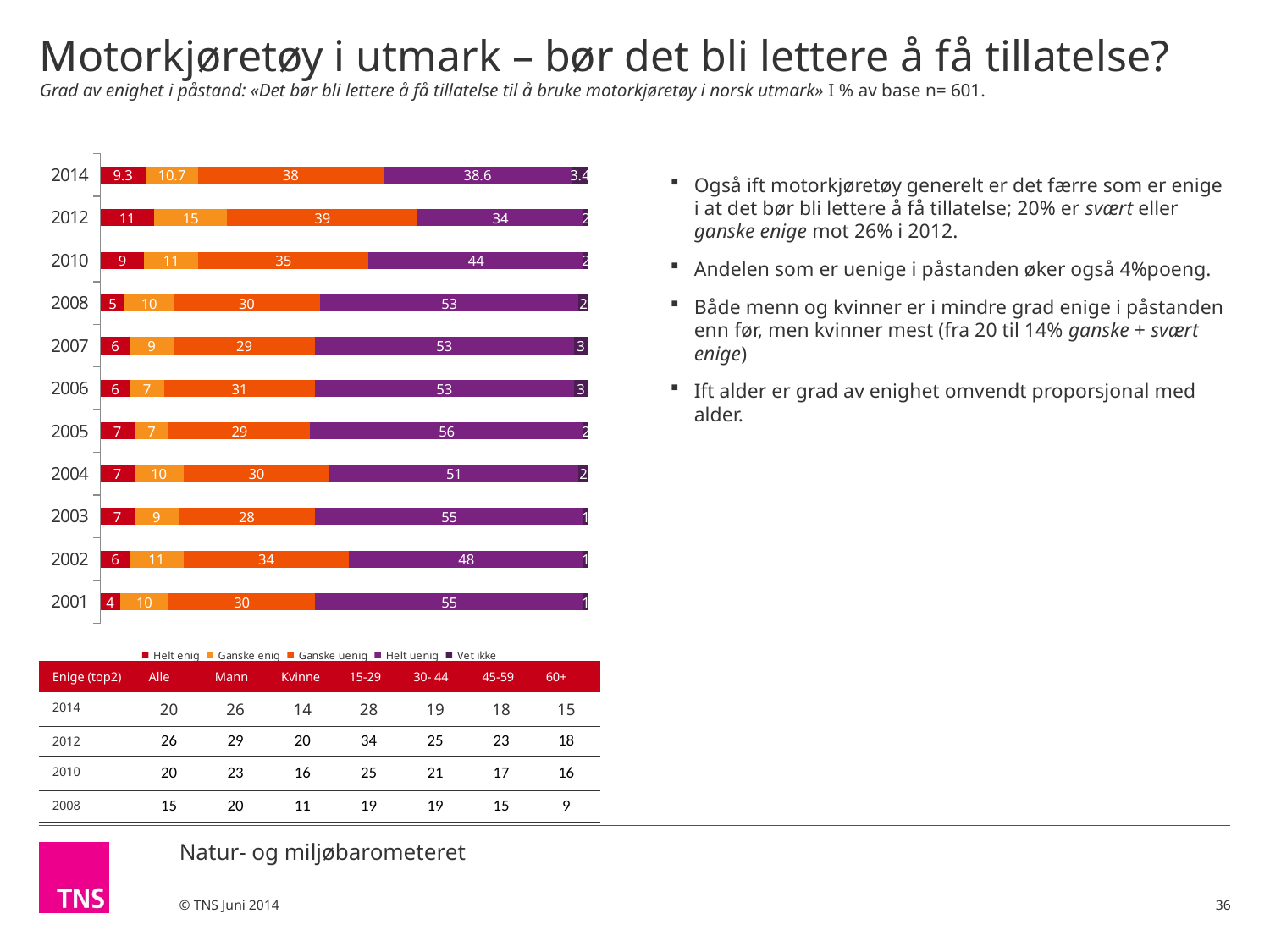
What is the value for Helt uenig in 2010? 44 What kind of chart is shown on the slide? Stacked bar chart What is the difference between the Ganske uenig value in 2012 and in 2001? 9 What is the value for Vet ikke in 2014? 3.4 How many years are shown in the chart? 11 What is the total of the stacked bar for 2008? 100 What is the value for Helt enig in 2014? 9.3 In which year is the Helt uenig value highest? 2005 How many series does the legend list? 5 In which year is the Helt enig value lowest? 2001 Does the Helt uenig value rise or fall from 2001 to 2014? Fall Which year has the larger Helt uenig value, 2008 or 2014? 2008